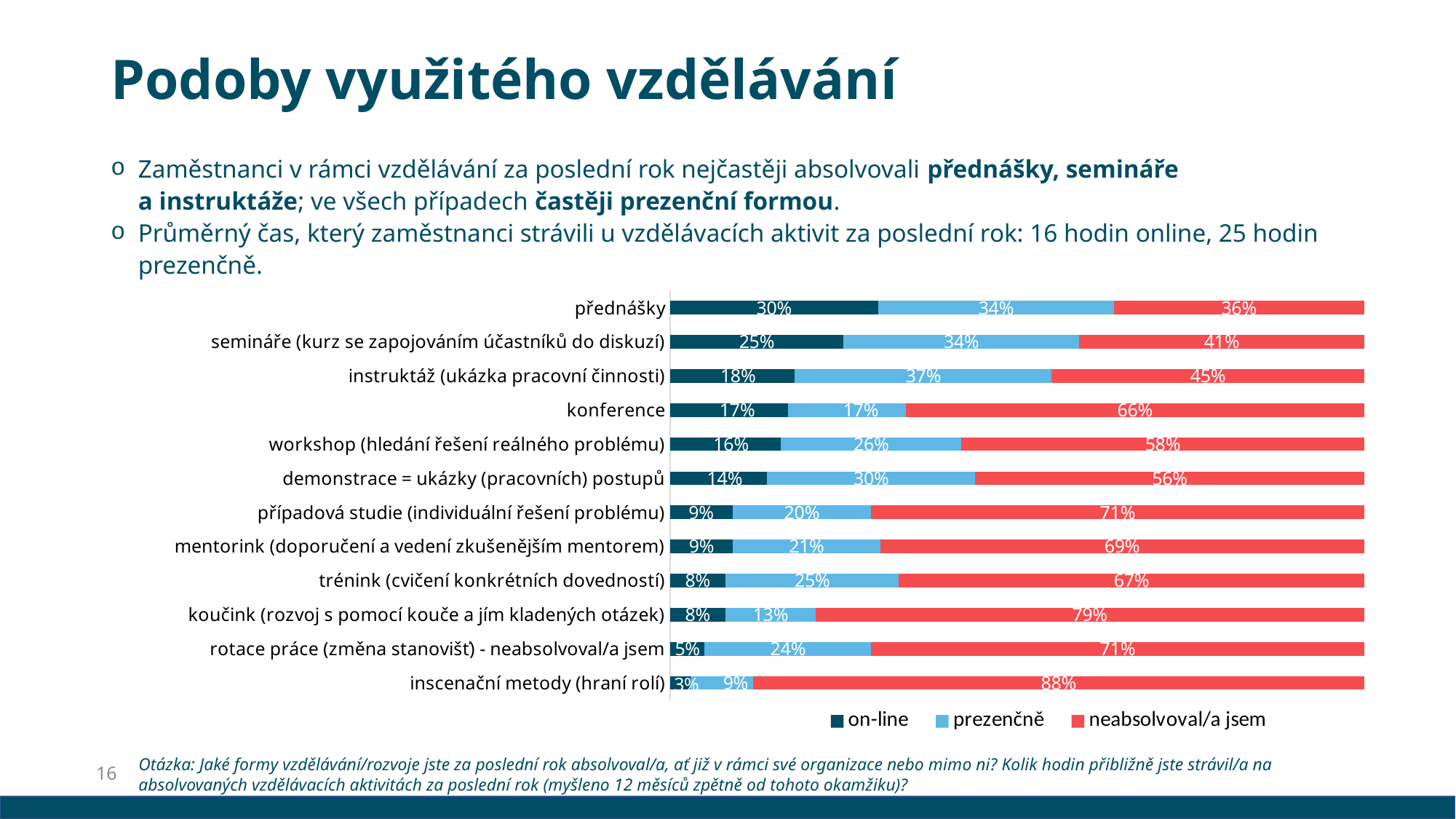
Which is larger: the prezenčně value for workshop (hledání řešení reálného problému) or the prezenčně value for demonstrace = ukázky (pracovních) postupů? demonstrace = ukázky (pracovních) postupů Which series is shown in red in the chart? neabsolvoval/a jsem What is the neabsolvoval/a jsem value for koučink (rozvoj s pomocí kouče a jím kladených otázek)? 79% What is the prezenčně value for instruktáž (ukázka pracovní činnosti)? 37% What kind of chart is shown on the slide? stacked bar chart What is the difference between the neabsolvoval/a jsem value for konference and the neabsolvoval/a jsem value for přednášky? 30% What is the on-line value for přednášky? 30% How many categories are shown in the chart? 12 Which category has the lowest on-line value? inscenační metody (hraní rolí) Which category has the highest neabsolvoval/a jsem value? inscenační metody (hraní rolí) What is the total of the on-line and prezenčně values for semináře (kurz se zapojováním účastníků do diskuzí)? 59% How many series does the legend list? 3